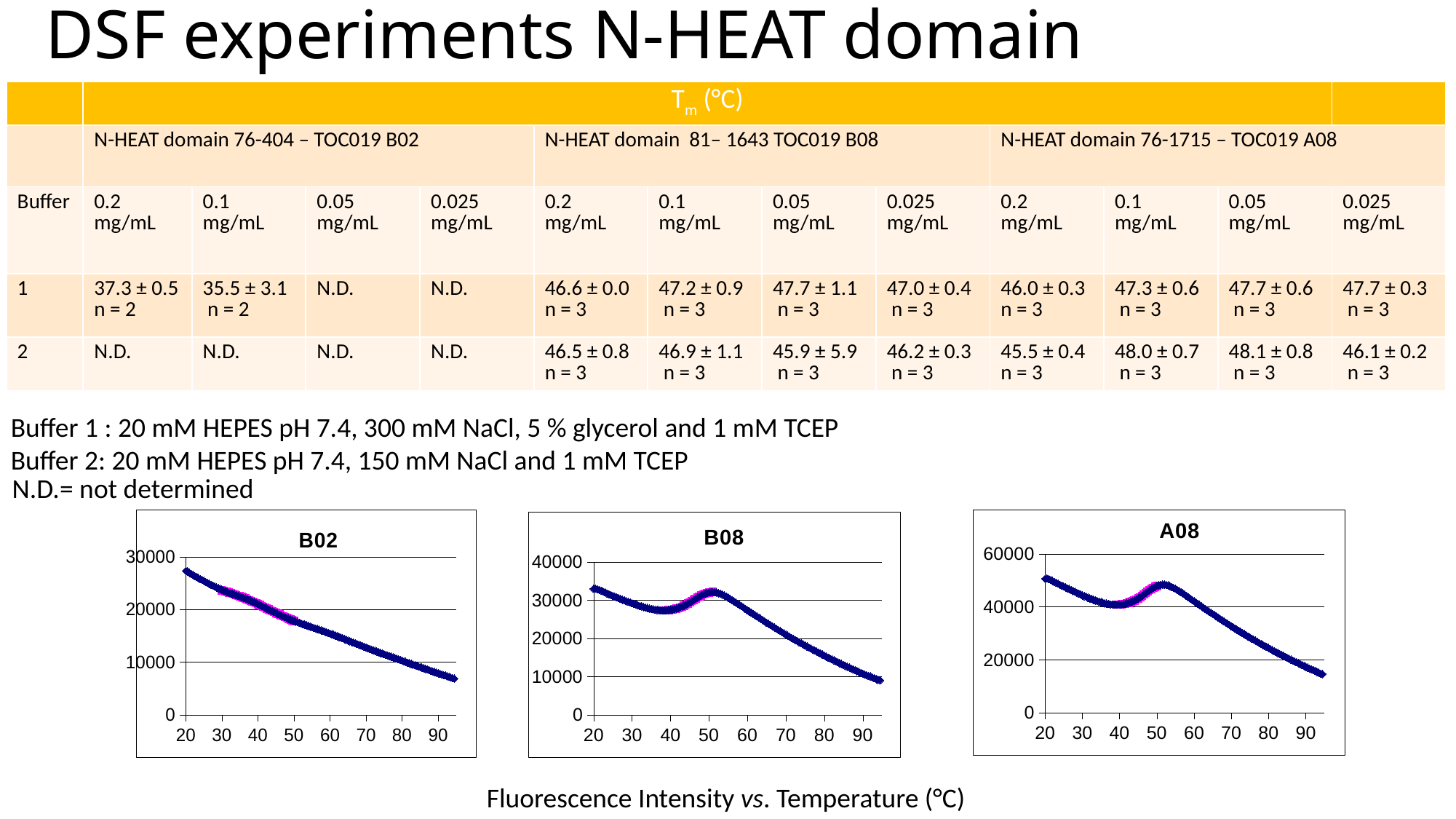
In the A08 chart, is the value at temperature 90 greater or less than 20000? less What kind of chart is the B02 chart? line chart What is the highest y-axis tick shown on the A08 chart? 60000 In the A08 chart, is the value at temperature 20 greater or less than 40000? greater In the B08 chart, is the value at temperature 20 greater or less than 30000? greater In the B02 chart, does the fluorescence intensity rise or fall overall as temperature increases from 20 to 90? fall How many charts are shown on the slide? 3 In the A08 chart, which is larger: the value at temperature 20 or the value at temperature 90? temperature 20 What is the title of the rightmost chart? A08